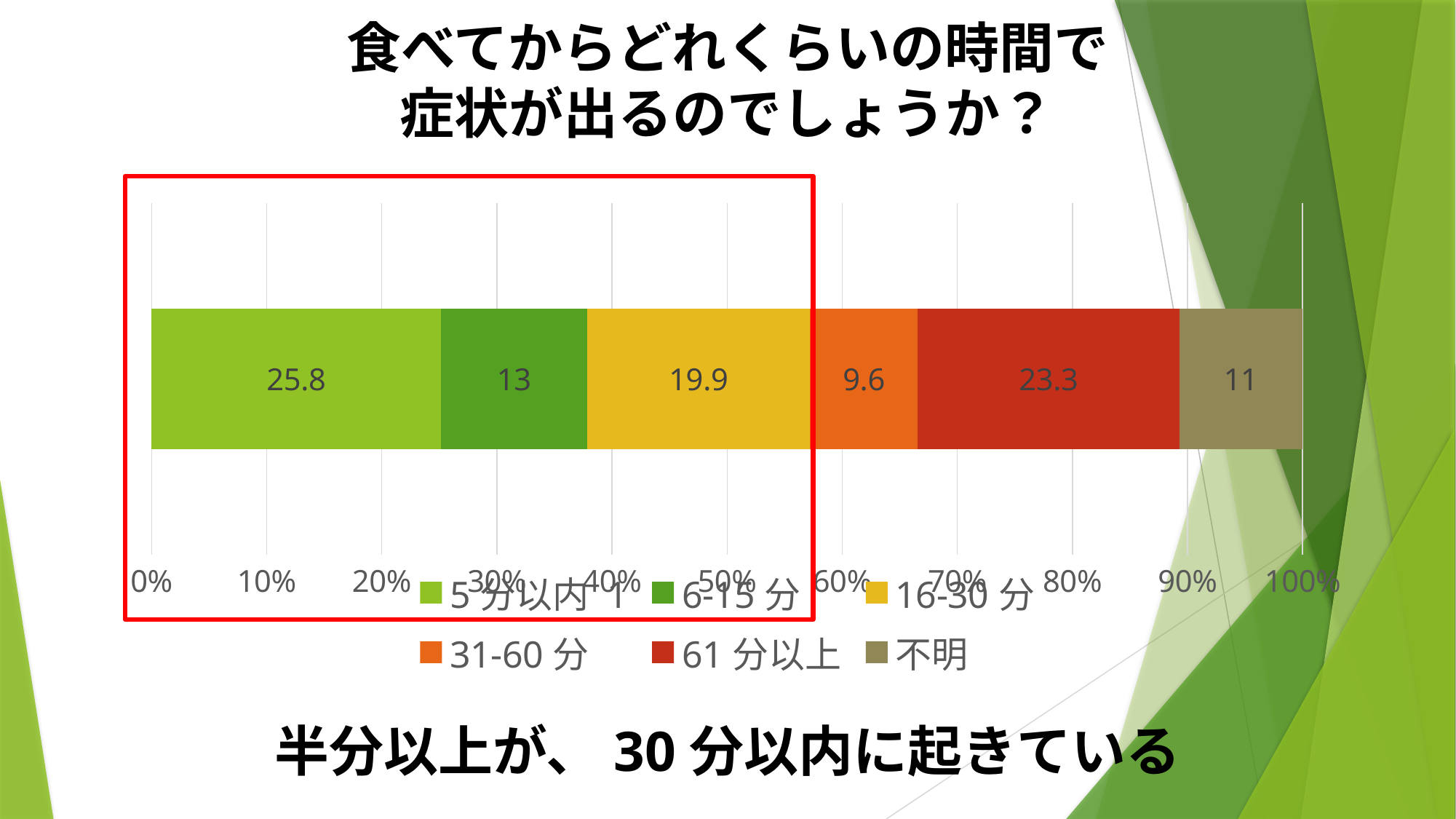
How many series does the legend list? 6 What is the combined value of the 5 分以内, 6-15 分 and 16-30 分 segments? 58.7 What is the difference between the 5 分以内 value and the 6-15 分 value? 12.8 What is the value for the 31-60 分 segment? 9.6 What is the value for the 5 分以内 segment? 25.8 What is the value for the 不明 segment? 11 What colour is the 61 分以上 segment? Red What kind of chart is shown on the slide? Stacked bar chart Which is larger, the 16-30 分 value or the 61 分以上 value? 61 分以上 What is the value for the 61 分以上 segment? 23.3 Which segment has the largest value? 5 分以内 Which segment has the smallest value? 31-60 分